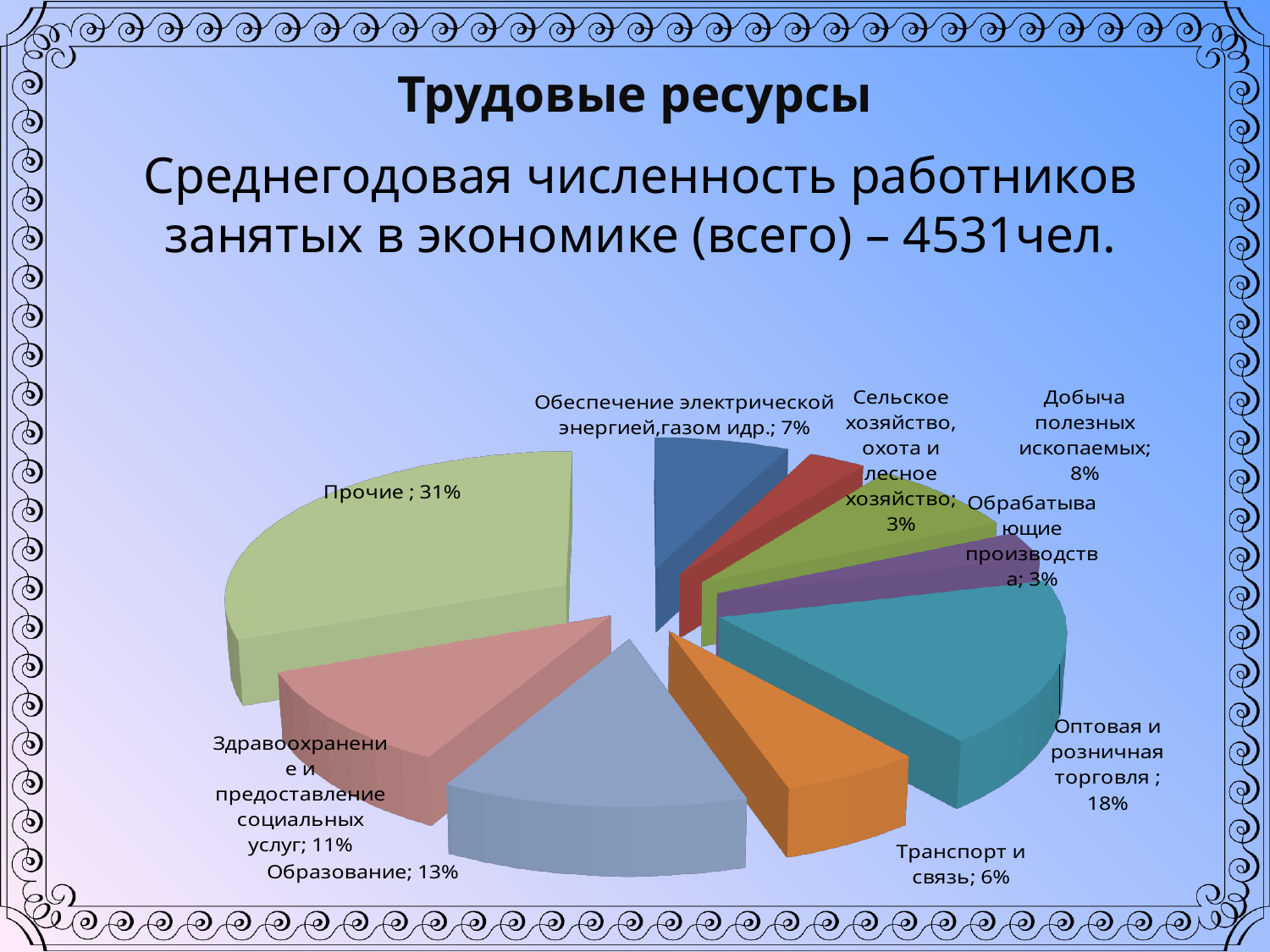
What total number of workers employed in the economy is stated on the slide? 4531 чел. What is the value for "Обеспечение электрической энергией, газом и др."? 7% What is the value for "Образование"? 13% What is the value for "Добыча полезных ископаемых"? 8% What share of the pie does "Прочие" have? 31% Which is larger: "Здравоохранение и предоставление социальных услуг" or "Образование"? Образование What is the difference between "Оптовая и розничная торговля" and "Транспорт и связь"? 12% Which category has the largest slice of the pie? Прочие What is the value for "Оптовая и розничная торговля"? 18% What is the value for "Транспорт и связь"? 6% What type of chart is shown on the slide? pie chart How many slices does the pie chart have? 9